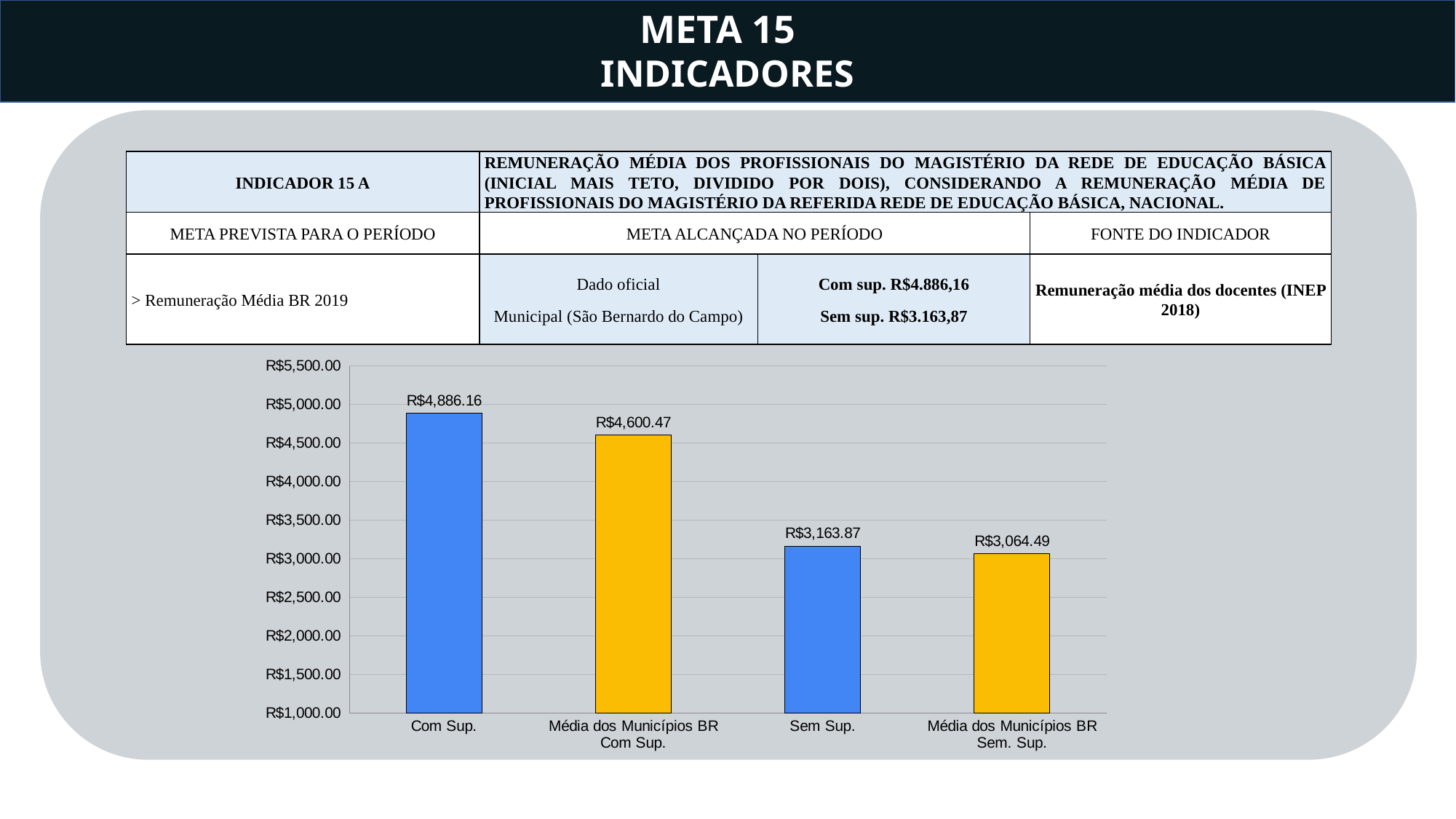
What is the value for Média dos Municípios BR Sem. Sup.? R$3,064.49 What is the value for Com Sup.? R$4,886.16 What is the difference between the values for Sem Sup. and Média dos Municípios BR Sem. Sup.? R$99.38 What is the difference between the values for Com Sup. and Média dos Municípios BR Com Sup.? R$285.69 Which category has the lowest value? Média dos Municípios BR Sem. Sup. What is the value for Média dos Municípios BR Com Sup.? R$4,600.47 What is the value for Sem Sup.? R$3,163.87 How many bars are plotted in the chart? 4 What type of chart is shown on the slide? Bar chart Which is larger, the value for Com Sup. or the value for Sem Sup.? Com Sup. Is the value for Média dos Municípios BR Com Sup. greater or less than R$4,500.00? greater Which category has the highest value? Com Sup.